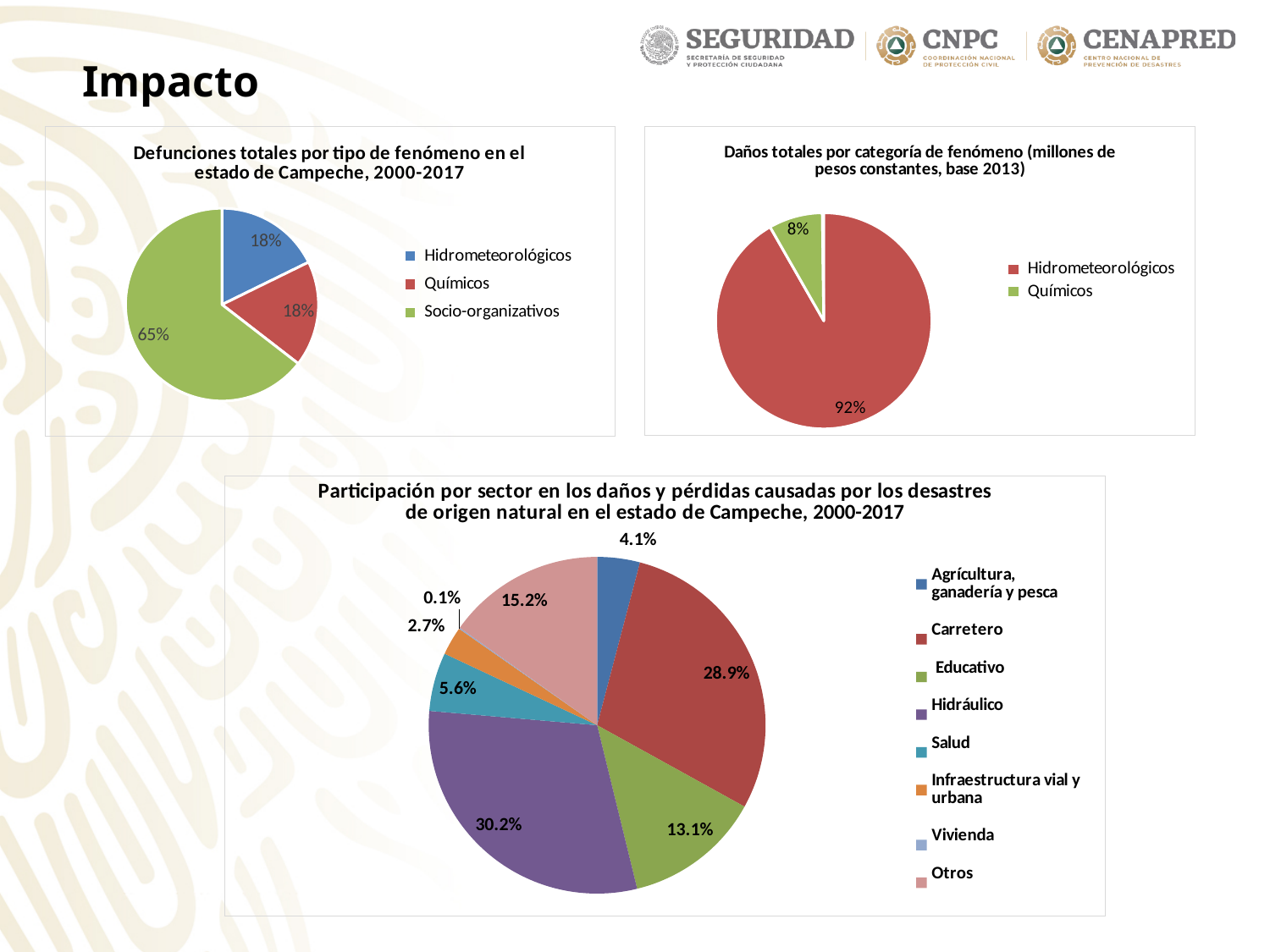
In the chart titled 'Participación por sector en los daños y pérdidas causadas por los desastres de origen natural en el estado de Campeche, 2000-2017', which sector has the smallest share? Vivienda In the chart titled 'Daños totales por categoría de fenómeno (millones de pesos constantes, base 2013)', what share do Químicos account for? 8% What kind of chart is the one titled 'Participación por sector en los daños y pérdidas causadas por los desastres de origen natural en el estado de Campeche, 2000-2017'? Pie chart In the chart titled 'Participación por sector en los daños y pérdidas causadas por los desastres de origen natural en el estado de Campeche, 2000-2017', how many sectors does the legend list? 8 In the chart titled 'Defunciones totales por tipo de fenómeno en el estado de Campeche, 2000-2017', what share do Hidrometeorológicos account for? 18% In the chart titled 'Defunciones totales por tipo de fenómeno en el estado de Campeche, 2000-2017', which category has the largest share? Socio-organizativos In the chart titled 'Participación por sector en los daños y pérdidas causadas por los desastres de origen natural en el estado de Campeche, 2000-2017', which sector has the largest share? Hidráulico How many categories does the legend list in the chart titled 'Defunciones totales por tipo de fenómeno en el estado de Campeche, 2000-2017'? 3 In the chart titled 'Participación por sector en los daños y pérdidas causadas por los desastres de origen natural en el estado de Campeche, 2000-2017', what is the share for Carretero? 28.9% In the chart titled 'Daños totales por categoría de fenómeno (millones de pesos constantes, base 2013)', what is the difference between the Hidrometeorológicos and Químicos shares? 84%